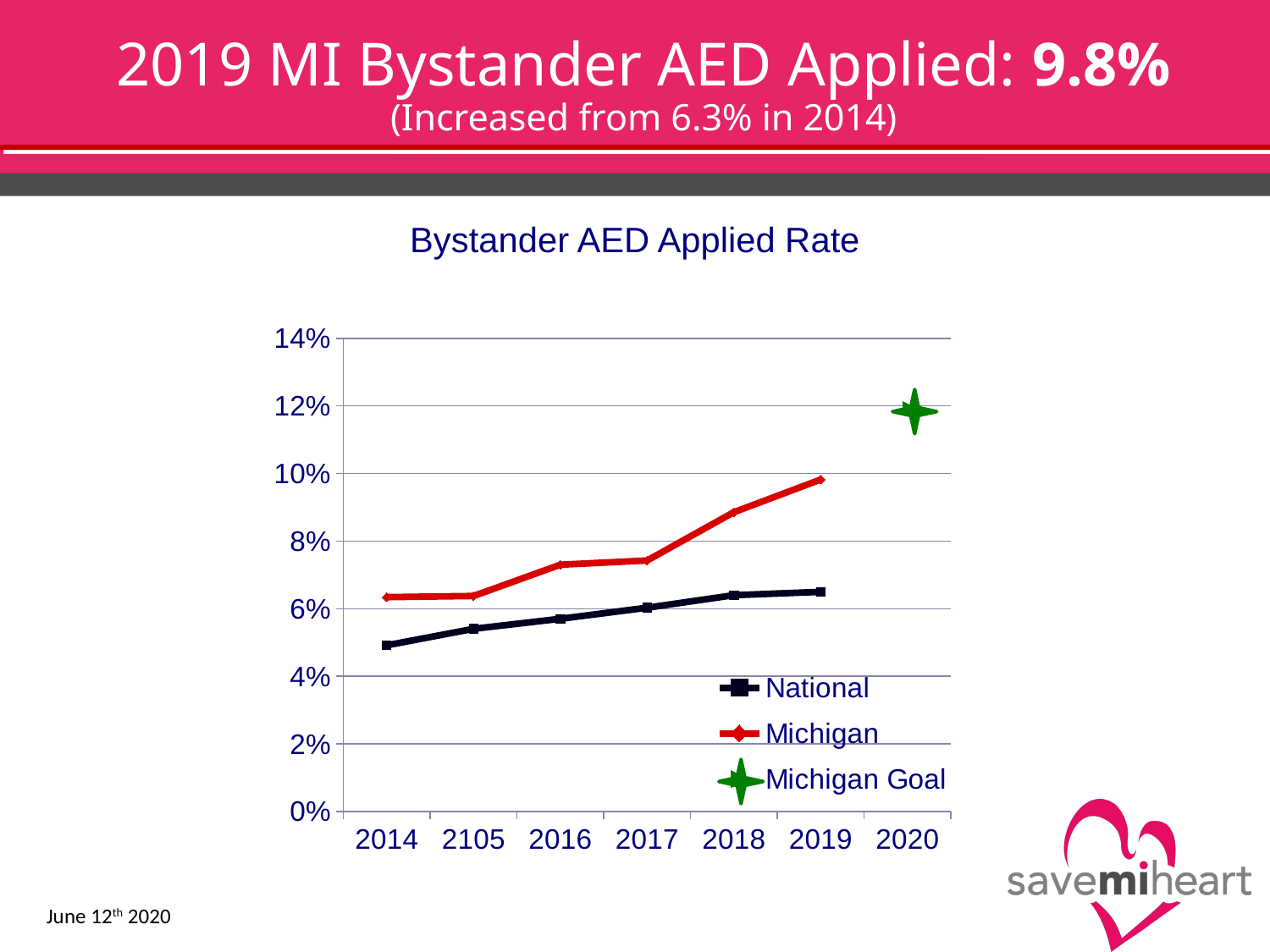
Is the Michigan value for 2018 greater or less than 8%? greater Does the Michigan line rise or fall from 2014 to 2019? rise What is the title of the chart? Bystander AED Applied Rate How many series does the legend list? 3 What type of chart is shown on the slide? line chart What was the Michigan bystander AED applied rate in 2014? 6.3% How many years are labelled on the x axis? 7 Is the Michigan Goal value for 2020 greater or less than 10%? greater In 2019, which series has the higher value, National or Michigan? Michigan Is the National value for 2014 greater or less than 6%? less By how many percentage points did the Michigan rate increase from 2014 to 2019? 3.5 What is the Michigan bystander AED applied rate for 2019? 9.8%